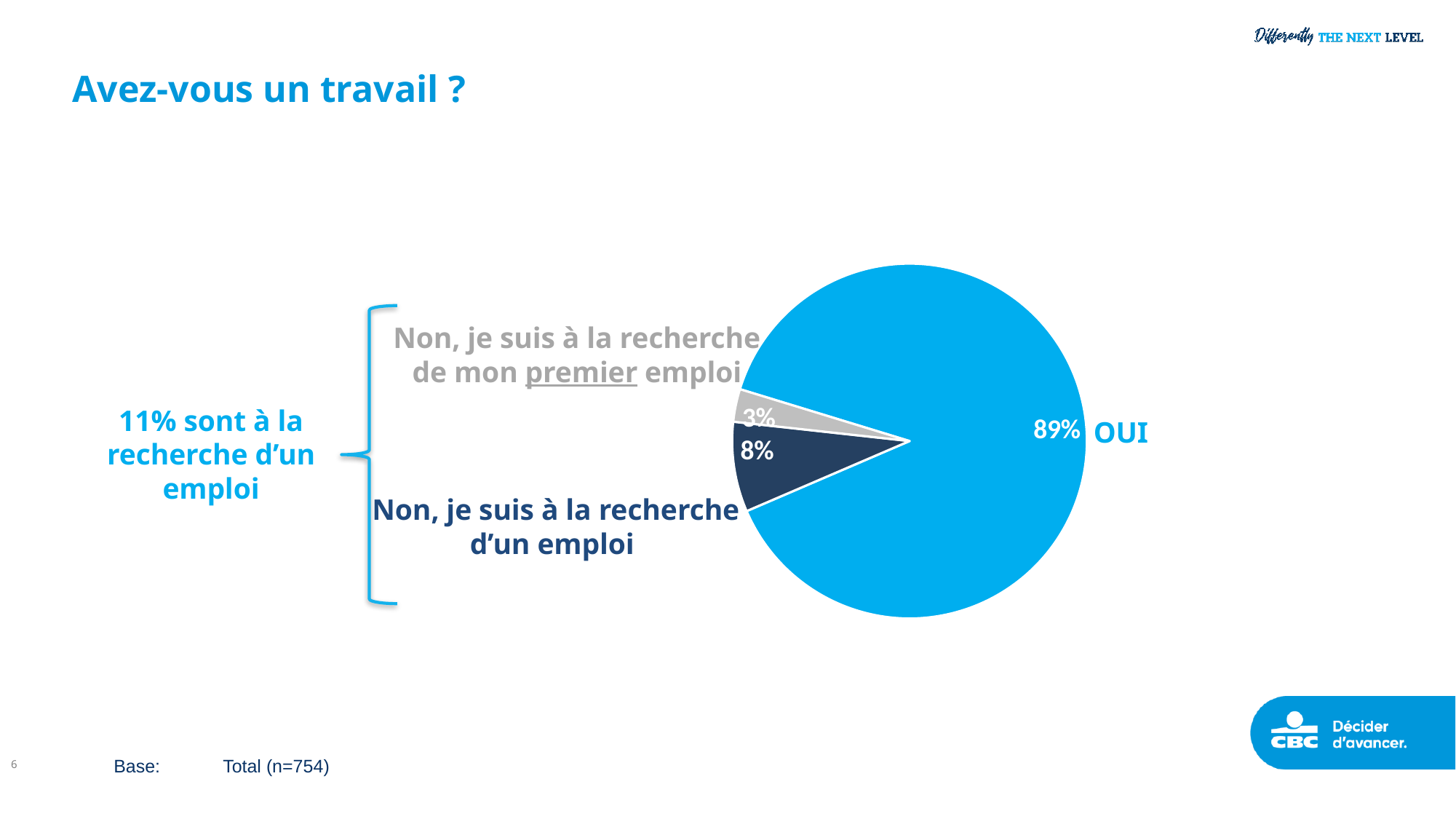
What is the base (sample size) stated for the chart? Total (n=754) What percentage of respondents answered "Non, je suis à la recherche d'un emploi"? 8% Which is larger: the share for "Non, je suis à la recherche d'un emploi" or for "Non, je suis à la recherche de mon premier emploi"? Non, je suis à la recherche d'un emploi What percentage of respondents answered "OUI"? 89% What is the title of the slide containing the pie chart? Avez-vous un travail ? How many slices does the pie chart have? 3 What is the combined share of the two "Non" slices? 11% What is the difference in percentage points between "OUI" and "Non, je suis à la recherche d'un emploi"? 81 What percentage of respondents are looking for their first job ("Non, je suis à la recherche de mon premier emploi")? 3% Which slice of the pie is the smallest? Non, je suis à la recherche de mon premier emploi What kind of chart is shown on the slide? pie chart Which slice of the pie is the largest? OUI